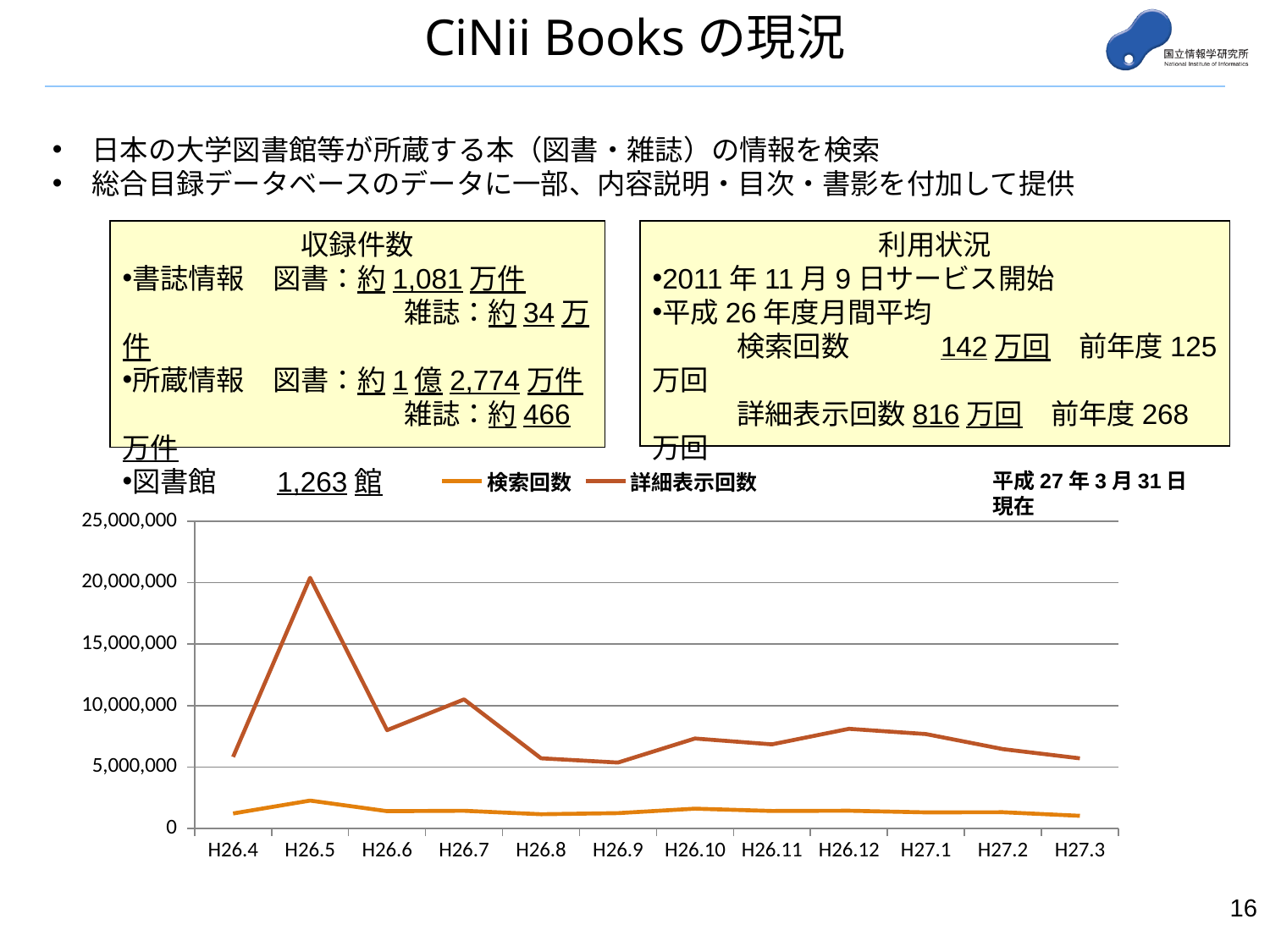
What kind of chart is shown at the bottom of the slide? Line chart Does 詳細表示回数 rise or fall from H26.5 to H26.9? Fall Is the value of 詳細表示回数 for H26.7 greater or less than 5,000,000? greater In which month does 検索回数 reach its highest value? H26.5 In which month does 詳細表示回数 reach its highest value? H26.5 At H26.4, which series has the larger value, 検索回数 or 詳細表示回数? 詳細表示回数 Is the value of 検索回数 for H26.5 greater or less than 5,000,000? less Is the value of 詳細表示回数 for H26.5 greater or less than 15,000,000? greater Which is larger, 詳細表示回数 for H26.5 or 詳細表示回数 for H26.6? H26.5 What are the two series named in the chart legend? 検索回数 and 詳細表示回数 How many series does the chart legend list? 2 How many months (points) are plotted along the x axis of the chart? 12